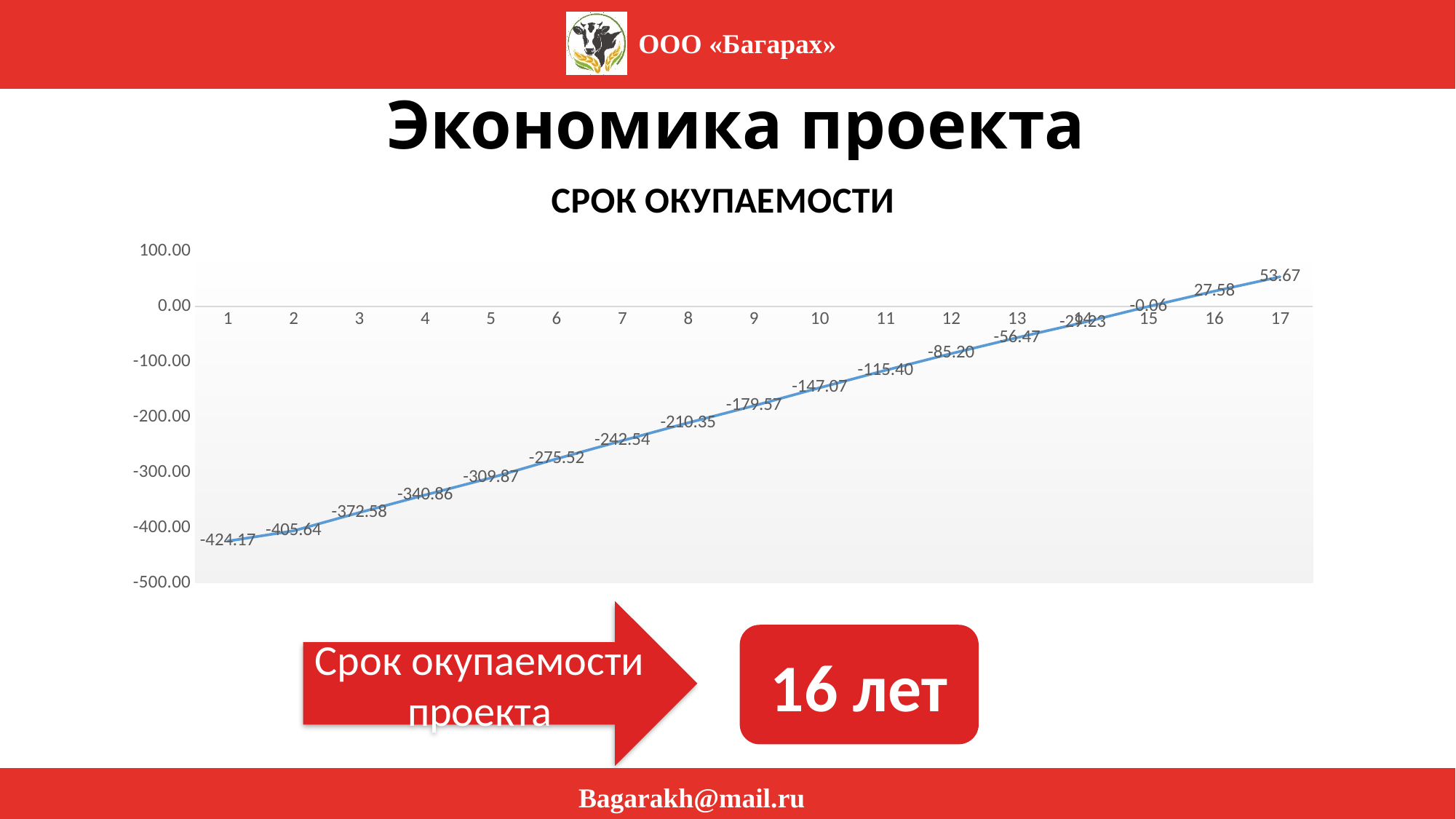
What is the value at point 15? -0.06 What kind of chart is shown on the slide? line chart Do the values rise or fall from point 1 to point 17? rise Is the value at point 5 greater or less than -300.00? less What is the value at point 1? -424.17 Which point has the lowest value? 1 What is the value at point 10? -147.07 What is the difference between the values at point 17 and point 16? 26.09 How many points are plotted on the line? 17 What is the title of the chart? СРОК ОКУПАЕМОСТИ What is the value at point 17? 53.67 Which point has the highest value? 17